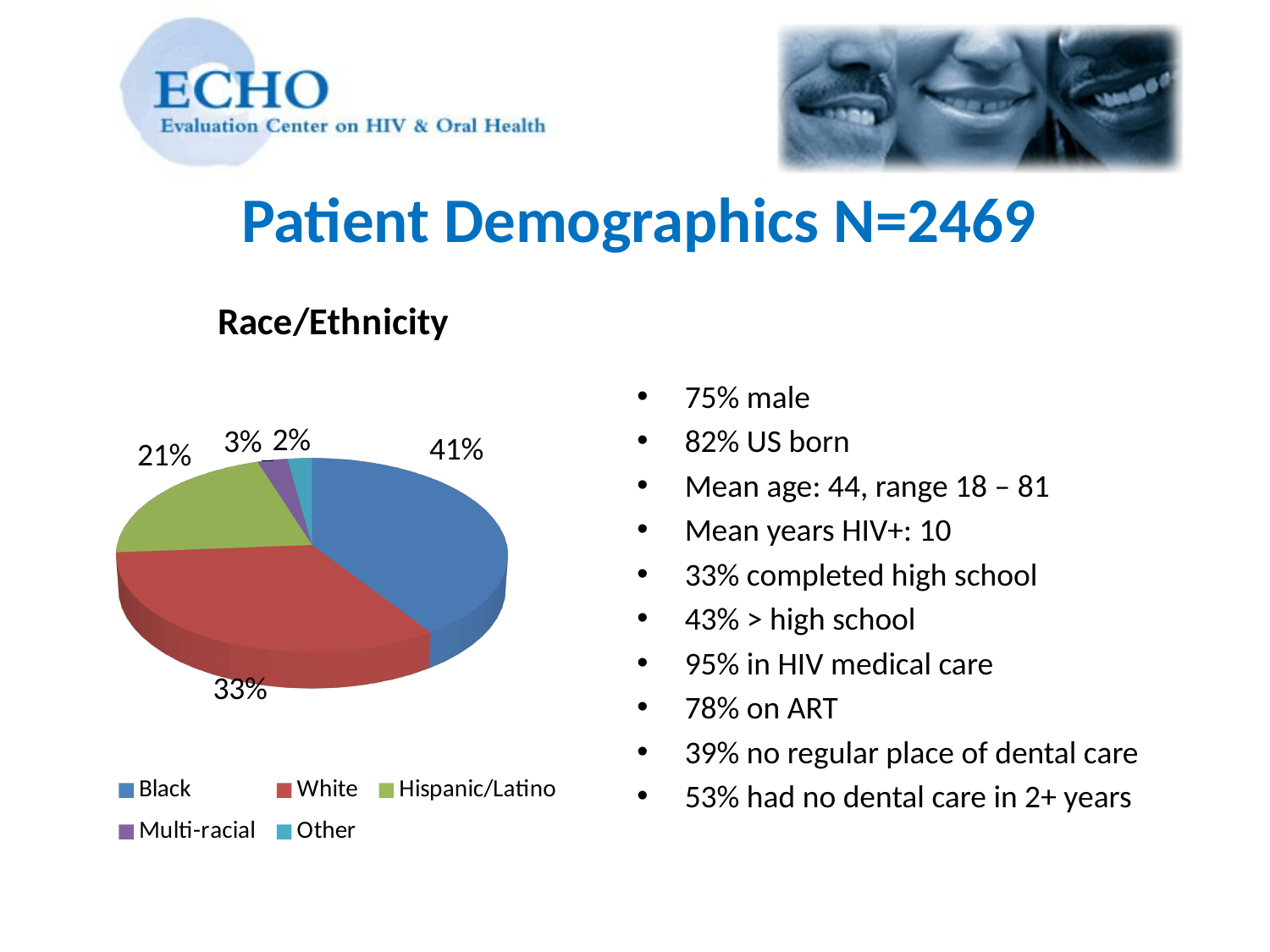
Which race/ethnicity category has the smallest share in the pie chart? Other What percentage of patients fall into the Other category in the Race/Ethnicity pie chart? 2% What kind of chart is shown under the heading Race/Ethnicity? Pie chart What percentage of patients are Multi-racial according to the Race/Ethnicity pie chart? 3% Which race/ethnicity category has the largest share in the pie chart? Black What percentage of patients are Black according to the Race/Ethnicity pie chart? 41% How many categories does the Race/Ethnicity pie chart show? 5 What percentage of patients are Hispanic/Latino according to the Race/Ethnicity pie chart? 21% How many percentage points larger is the Black share than the White share in the Race/Ethnicity pie chart? 8 What colour is the Hispanic/Latino slice in the Race/Ethnicity pie chart? Green What percentage of patients are White according to the Race/Ethnicity pie chart? 33% Which is larger in the Race/Ethnicity pie chart, the White share or the Hispanic/Latino share? White